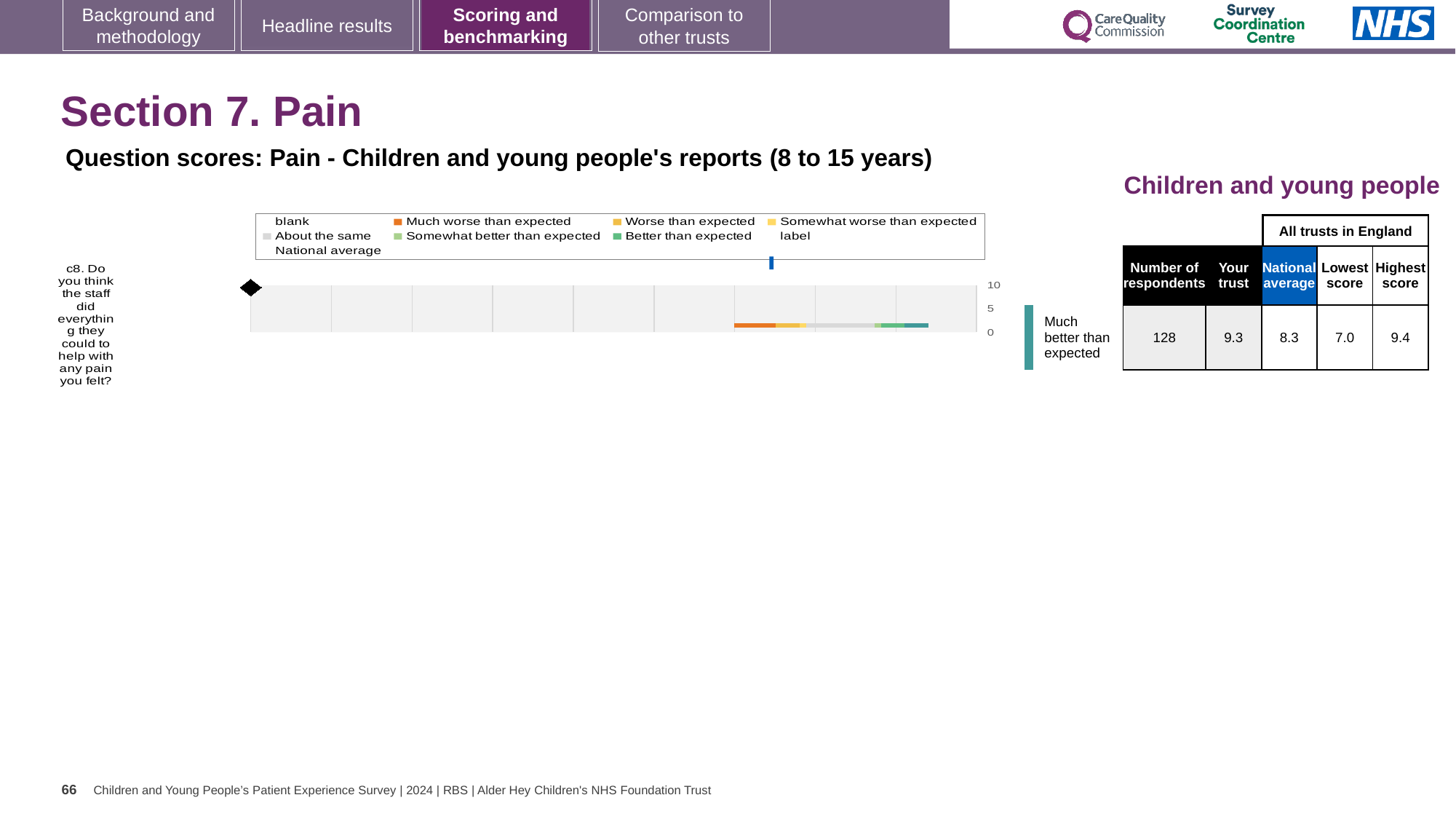
What is the score for Your trust on question c8? 9.3 What is the highest value shown on the chart's numeric axis? 10 What is the question label shown on the chart's vertical axis? c8. Do you think the staff did everything they could to help with any pain you felt? What kind of chart is shown on the slide? bar chart What is the difference between the Your trust score and the National average for question c8? 1.0 What is the Highest score among all trusts in England for question c8? 9.4 How many survey questions are plotted on the chart? 1 What is the National average score for question c8? 8.3 Which is larger for question c8, the Your trust score or the National average? Your trust How many respondents answered question c8? 128 What is the Lowest score among all trusts in England for question c8? 7.0 Which benchmarking category is the trust's result for question c8 placed in? Much better than expected